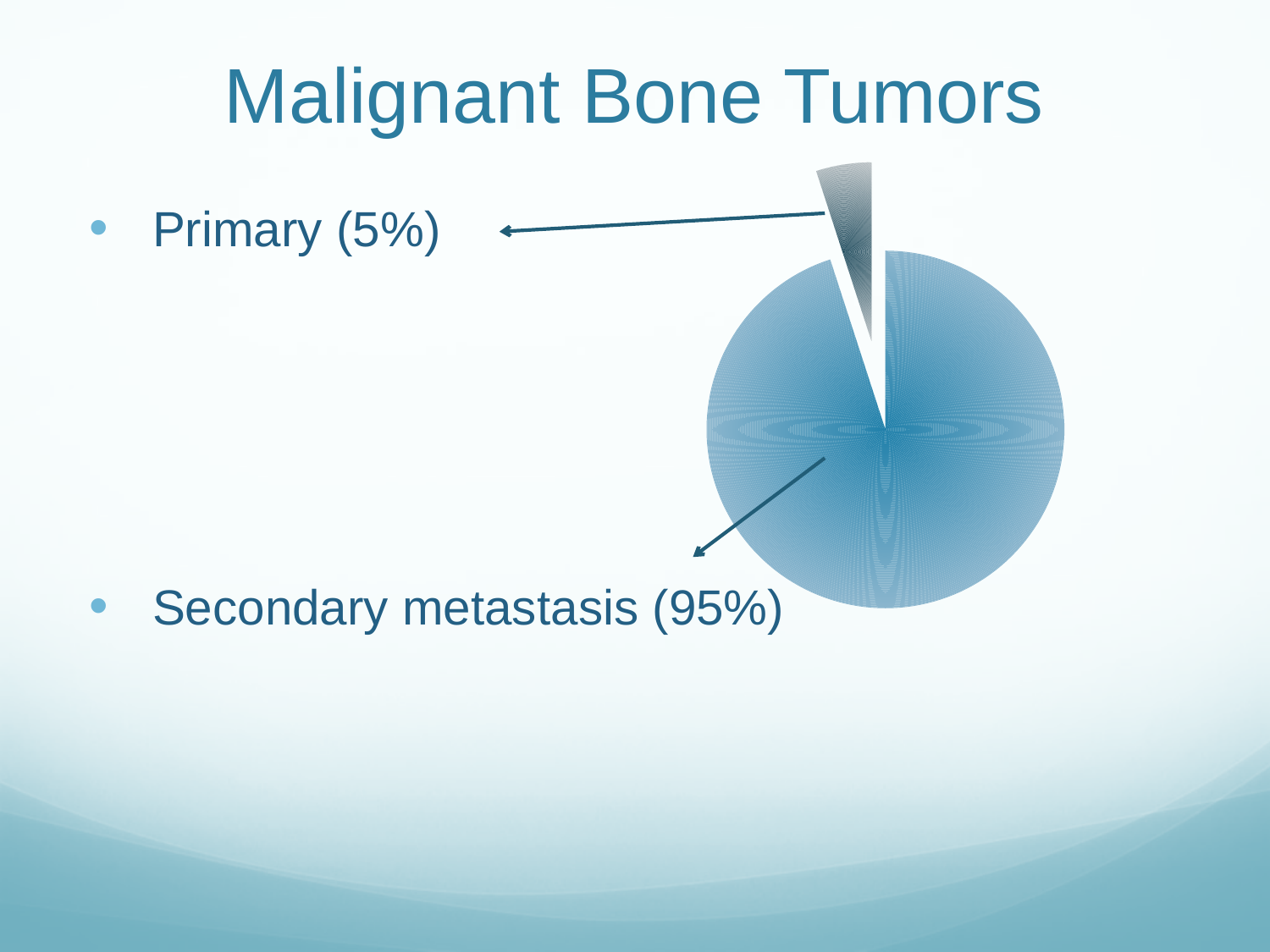
Which slice is pulled out (exploded) from the pie? Primary Which is larger, the share for primary or for secondary metastasis? Secondary metastasis What kind of chart is shown on the slide? pie chart What is the difference in percentage points between secondary metastasis and primary tumors? 90 Which category has the smallest slice of the pie? Primary What is the title of the slide containing the pie chart? Malignant Bone Tumors What share of malignant bone tumors is primary? 5% What share of malignant bone tumors is secondary metastasis? 95% Which category has the largest slice of the pie? Secondary metastasis How many slices does the pie chart have? 2